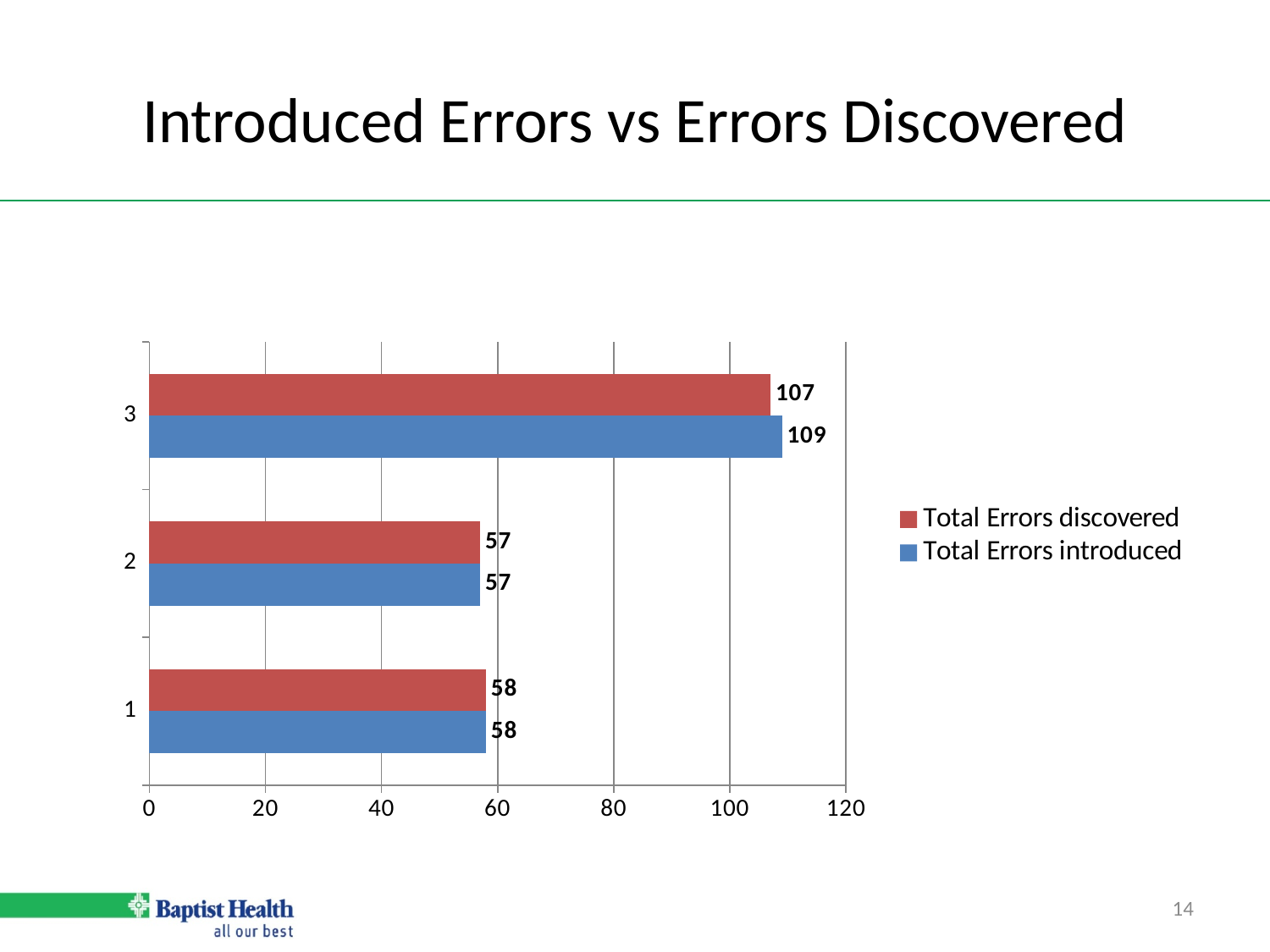
What is the value of Total Errors introduced for category 2? 57 Which category has the highest value for Total Errors introduced? 3 How many categories are shown on the chart? 3 What is the value of Total Errors discovered for category 3? 107 What is the difference between Total Errors introduced and Total Errors discovered for category 3? 2 What is the value of Total Errors introduced for category 3? 109 Which is larger for category 3: Total Errors introduced or Total Errors discovered? Total Errors introduced What is the value of Total Errors discovered for category 1? 58 How many series does the legend list? 2 What kind of chart is shown on the slide? bar chart Which category has the lowest value for Total Errors discovered? 2 Is the value of Total Errors introduced for category 3 greater or less than 100? greater